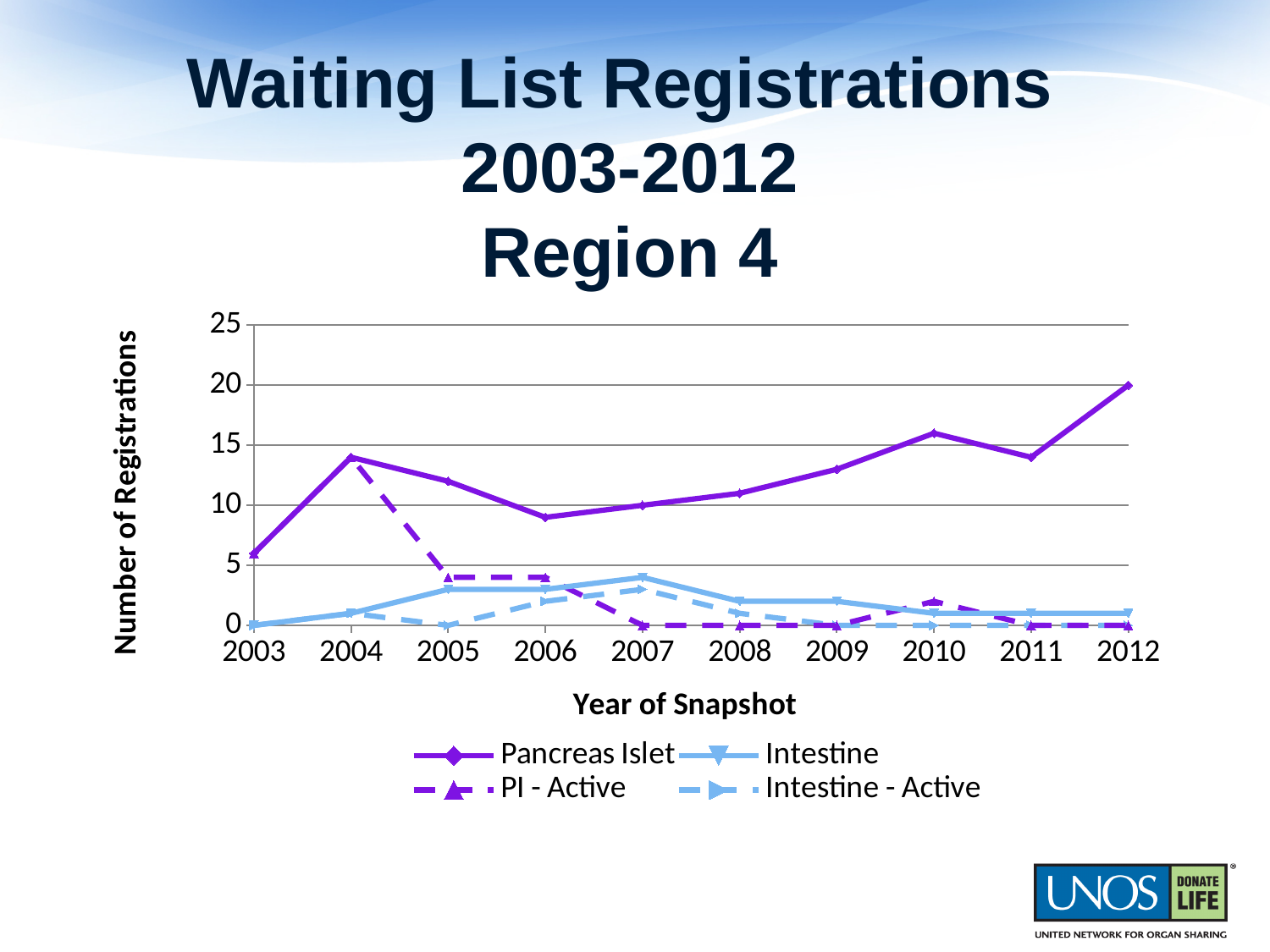
What is the PI - Active value in 2012? 0 What is the Pancreas Islet value in 2012? 20 What is the label of the y axis? Number of Registrations In which year is the Pancreas Islet series at its lowest? 2003 Is the Pancreas Islet value for 2010 greater or less than 15? greater In 2012, which series is larger, Pancreas Islet or Intestine? Pancreas Islet What kind of chart is shown on the slide? Line chart Does the Pancreas Islet series rise or fall from 2007 to 2010? Rise In which year is the Pancreas Islet series at its highest? 2012 Is the Intestine value for 2007 greater or less than 5? less How many years are shown along the x axis? 10 How many series does the legend list? 4